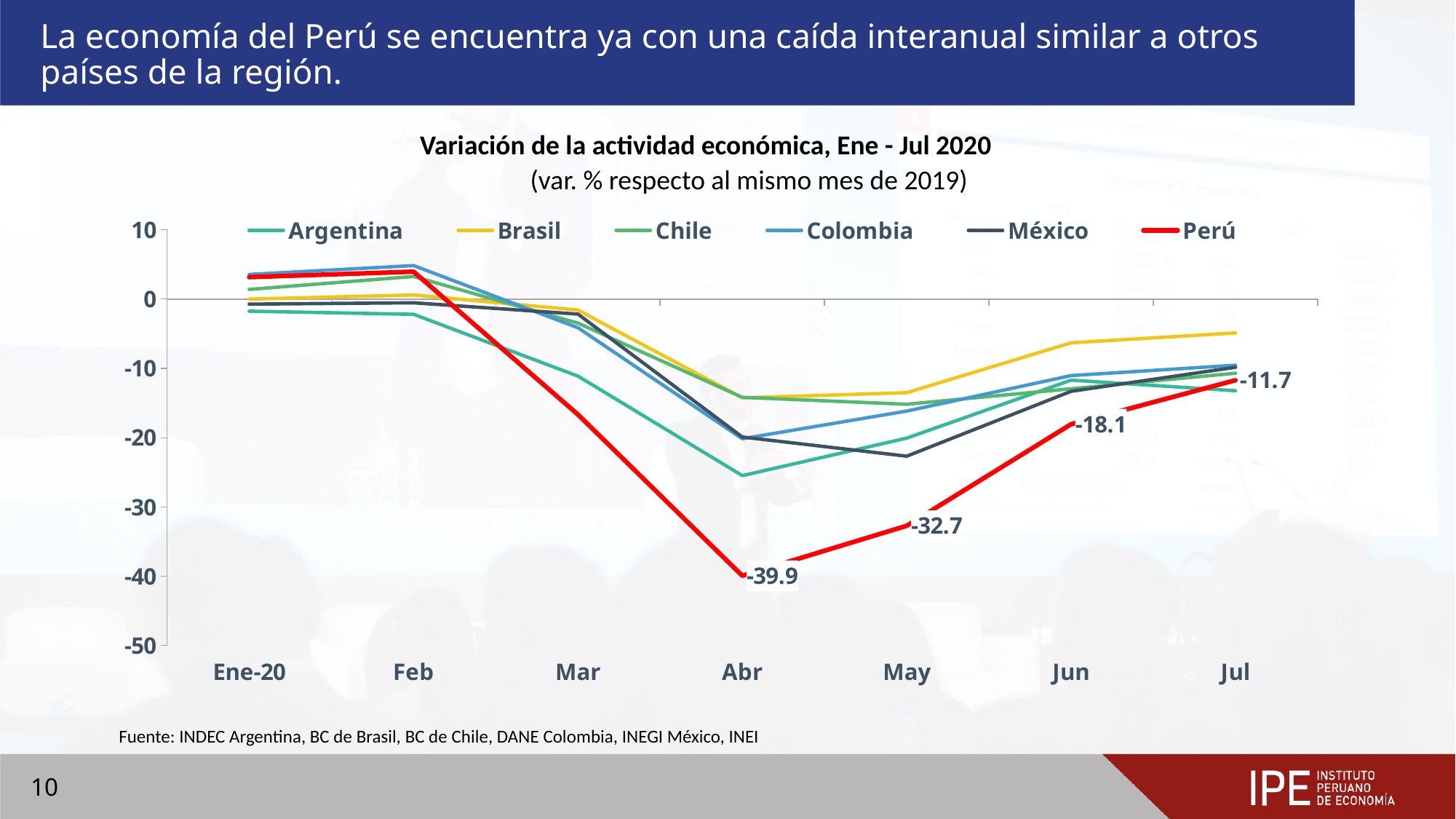
What is the value for Perú in May? -32.7 What is the value for Perú in Jul? -11.7 What kind of chart is shown on the slide? Line chart By how much did the value for Perú change between Abr and Jul? 28.2 Is the value for Brasil in Jul greater or less than -10? greater How many months are shown on the x axis? 7 What is the value for Perú in Jun? -18.1 How many series does the legend list? 6 Which country has the highest value in Jul? Brasil Which country has the lowest value in Abr? Perú Does the value for Perú rise or fall from Abr to Jul? Rises What is the value for Perú in Abr? -39.9